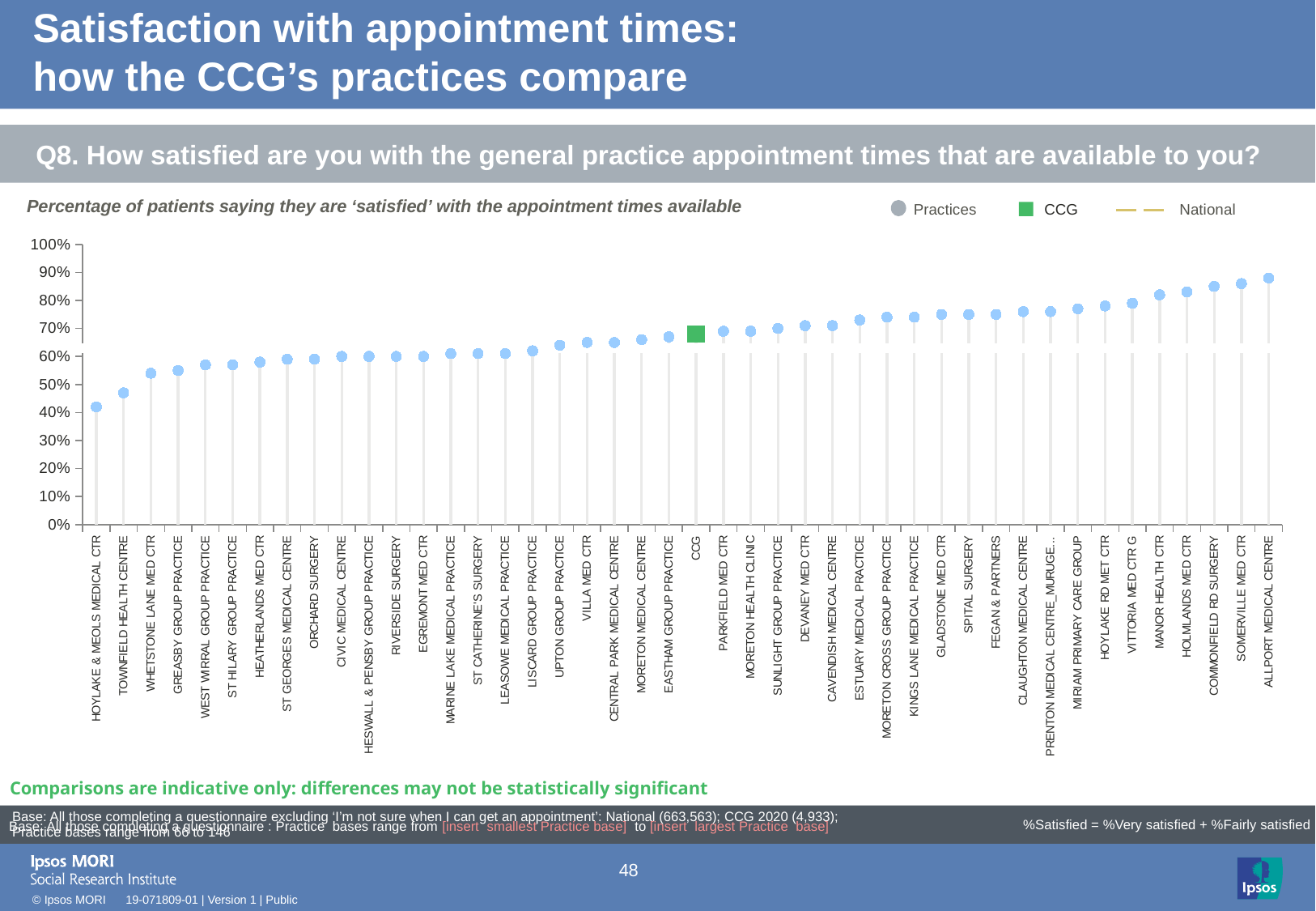
Which practice has the lowest percentage of patients satisfied with appointment times? Hoylake & Meols Medical Ctr How many entries does the legend list? 3 Is the value for Allport Medical Centre greater or less than 80%? greater How many categories are plotted along the x axis, including CCG? 44 Which practice has the highest percentage of patients satisfied with appointment times? Allport Medical Centre Which has a lower satisfaction percentage, Greasby Group Practice or Manor Health Ctr? Greasby Group Practice Is the value for Hoylake & Meols Medical Ctr greater or less than 50%? less What colour is the marker used for the CCG value? green Which has a higher satisfaction percentage, Somerville Med Ctr or Townfield Health Centre? Somerville Med Ctr Is the value for Townfield Health Centre greater or less than 50%? less Do the values rise or fall moving from left to right along the x axis? rise